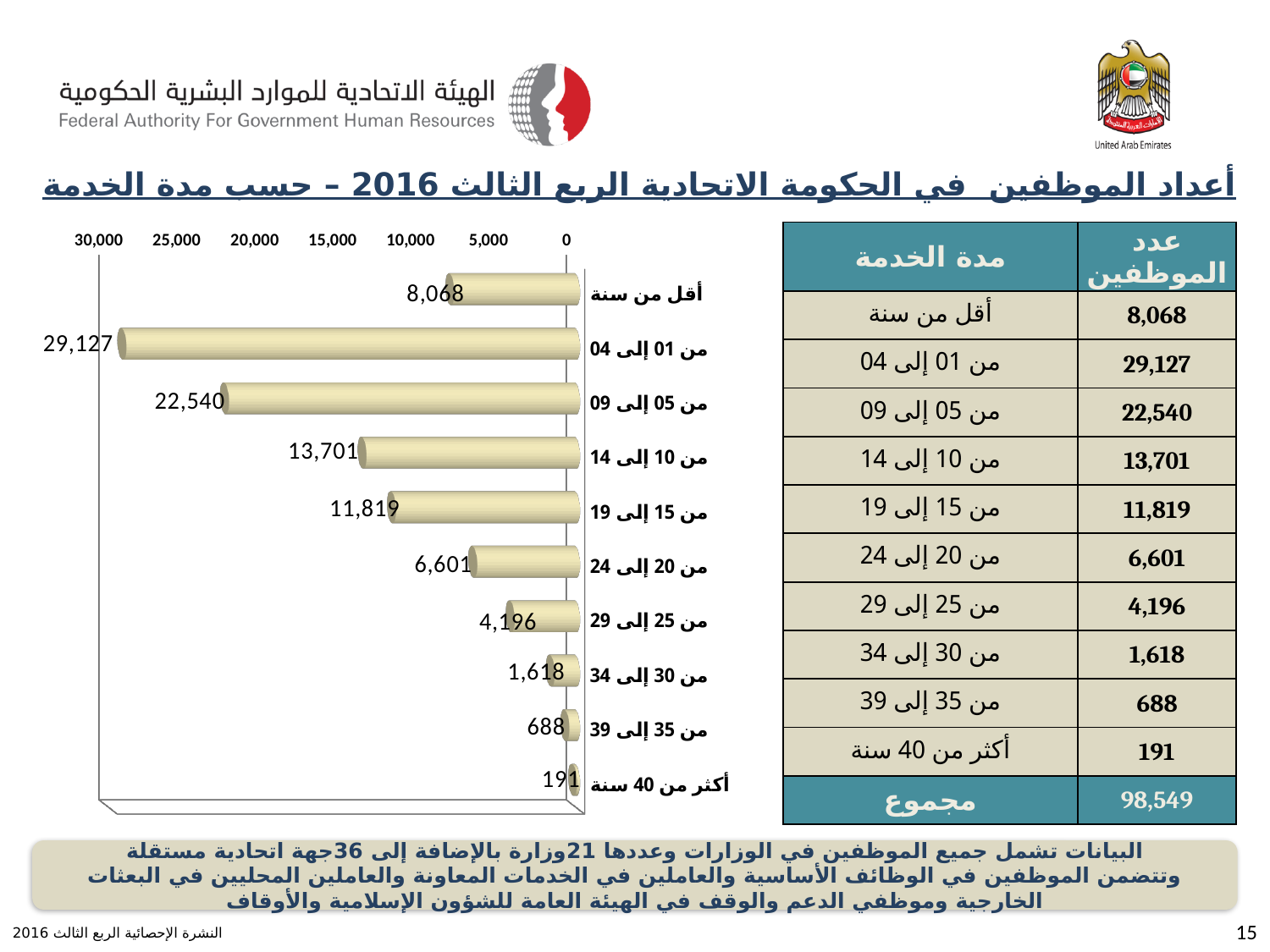
What is the number of employees for the category "أقل من سنة"? 8,068 What is the number of employees for the category "من 01 إلى 04"? 29,127 What is the number of employees for the category "أكثر من 40 سنة"? 191 What is the number of employees for the category "من 15 إلى 19"? 11,819 Is the value for "من 05 إلى 09" greater or less than 20,000? greater How many service-duration categories are plotted in the chart? 10 Which category has the highest number of employees? من 01 إلى 04 Which is larger, the value for "من 10 إلى 14" or the value for "من 15 إلى 19"? من 10 إلى 14 What type of chart is shown on the slide? Bar chart Which category has the lowest number of employees? أكثر من 40 سنة What is the difference between the values for "من 01 إلى 04" and "من 05 إلى 09"? 6,587 What is the total number of employees shown in the table (مجموع)? 98,549